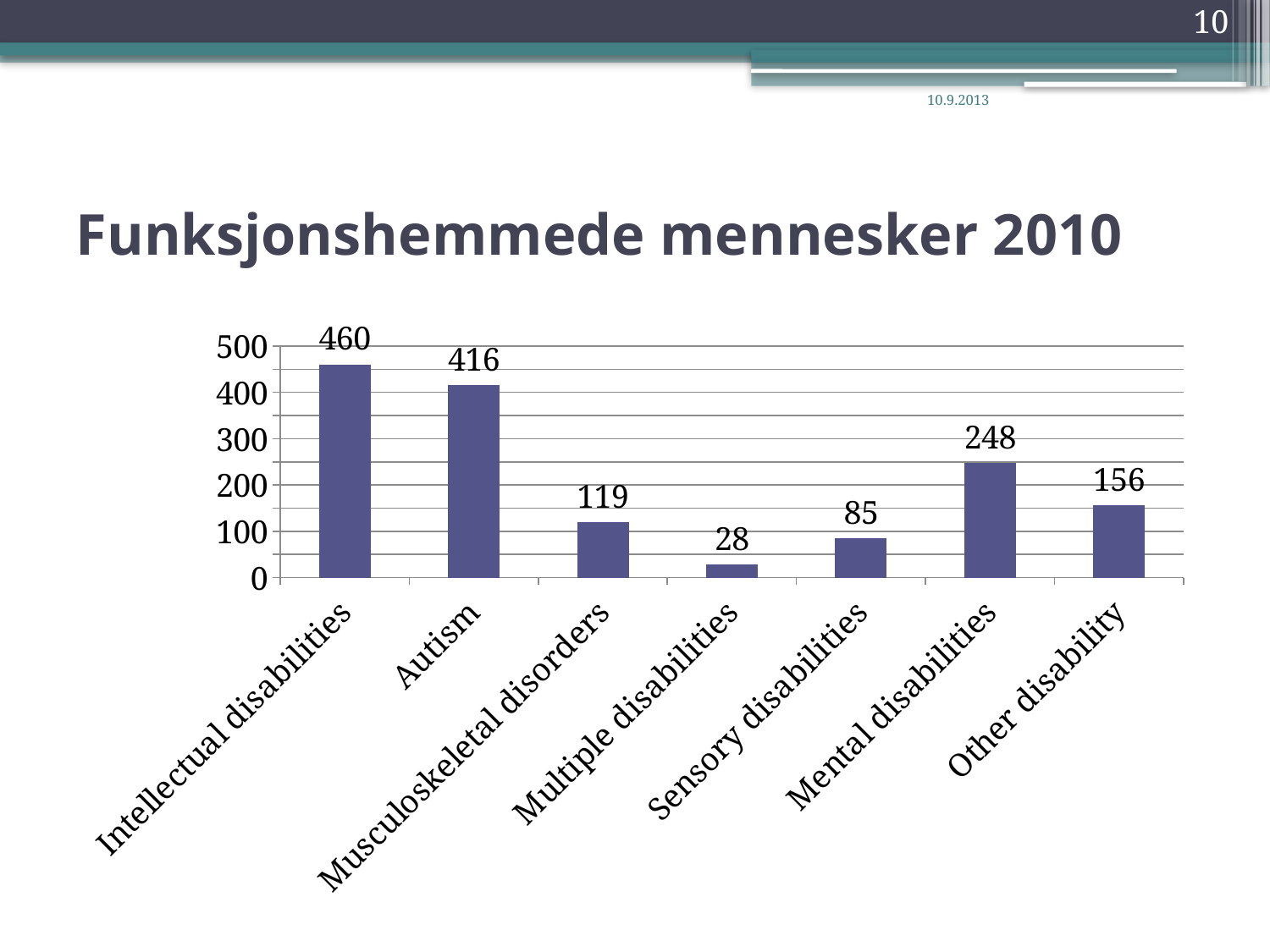
What is the value for Musculoskeletal disorders? 119 Is the value for Other disability greater or less than 100? greater What is the difference between the values for Mental disabilities and Other disability? 92 Which category has the highest value? Intellectual disabilities What is the value for Sensory disabilities? 85 Which is larger, the value for Mental disabilities or the value for Musculoskeletal disorders? Mental disabilities What is the value for Autism? 416 Which category has the lowest value? Multiple disabilities What kind of chart is shown on the slide? Bar chart What is the value for Intellectual disabilities? 460 How many categories are shown on the x axis? 7 What is the difference between the values for Intellectual disabilities and Autism? 44